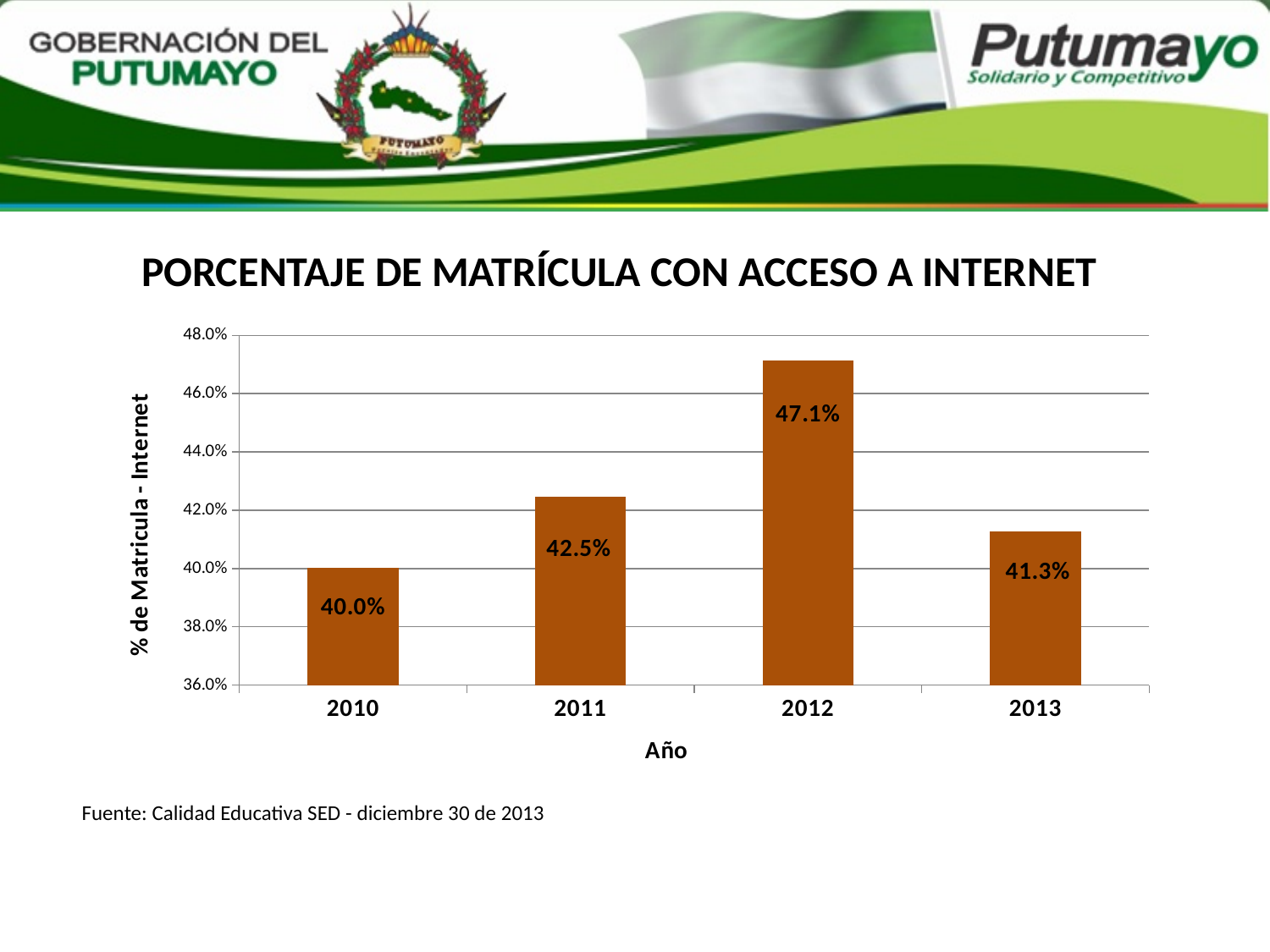
Which year has the lowest percentage of enrollment with internet access? 2010 What is the value shown for 2013? 41.3% How many years are shown on the x axis? 4 What is the title of the chart? PORCENTAJE DE MATRÍCULA CON ACCESO A INTERNET Which year has the highest percentage of enrollment with internet access? 2012 Does the percentage rise or fall from 2012 to 2013? Fall Which year has a larger value, 2011 or 2013? 2011 What is the difference in percentage points between 2012 and 2011? 4.6 What kind of chart is shown on the slide? Bar chart What is the percentage of enrollment with internet access in 2012? 47.1% Is the value for 2013 greater or less than 42.0%? less What is the percentage of enrollment with internet access in 2010? 40.0%